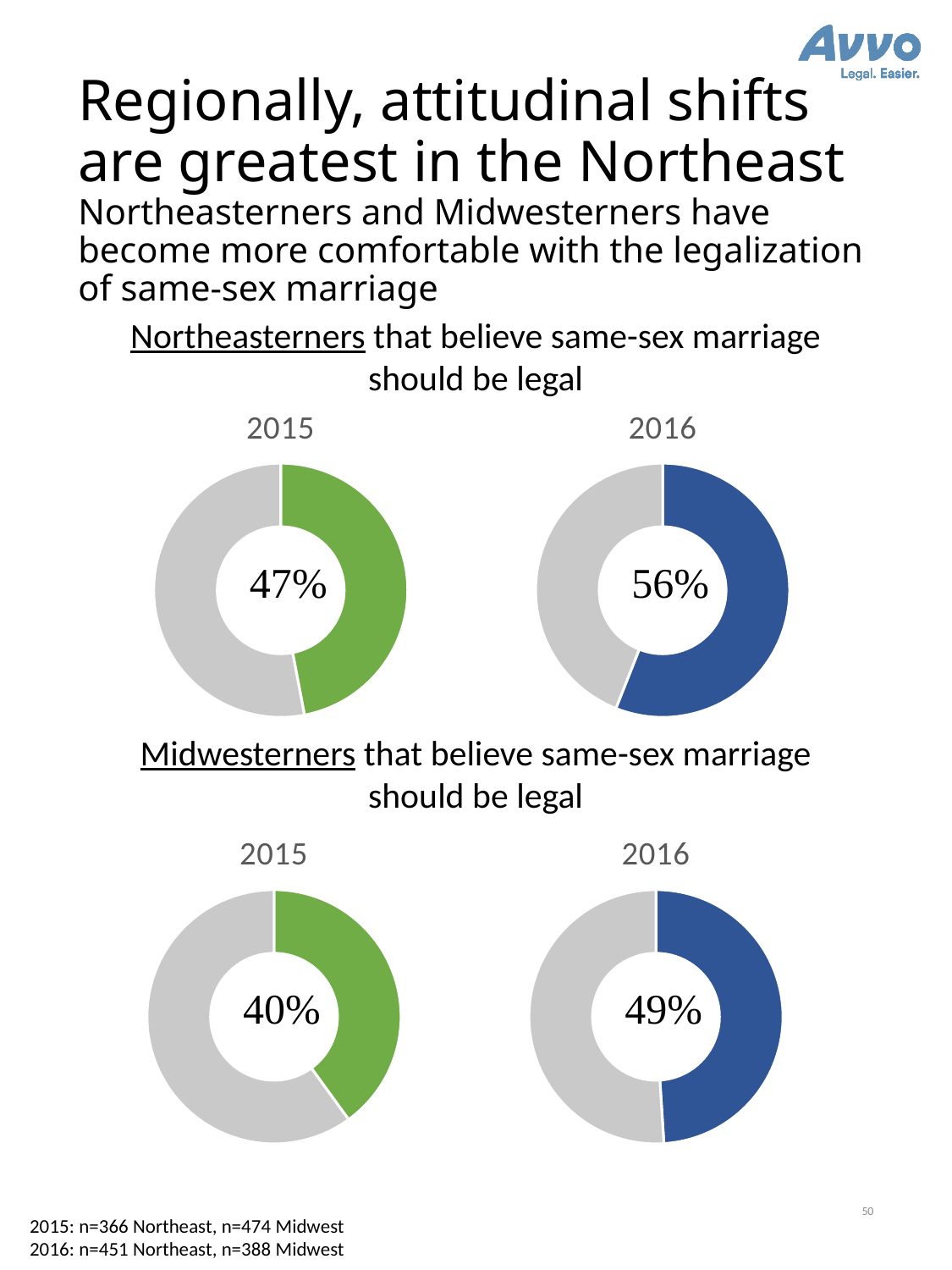
How many donut charts are shown on the slide? 4 Across all four donut charts on the slide, which chart shows the highest percentage? Northeasterners 2016 In the Northeasterners 2015 donut chart, what percentage believe same-sex marriage should be legal? 47% For the Northeasterners charts, by how many percentage points did the share believing same-sex marriage should be legal change from 2015 to 2016? 9 percentage points Across all four donut charts on the slide, which chart shows the lowest percentage? Midwesterners 2015 What kind of chart is used to show the percentages on this slide? donut chart In the Midwesterners 2016 donut chart, what percentage believe same-sex marriage should be legal? 49% Comparing the 2016 charts, which group has the larger share believing same-sex marriage should be legal, Northeasterners or Midwesterners? Northeasterners For the Northeasterners charts, did the share believing same-sex marriage should be legal rise or fall from 2015 to 2016? rise In the Midwesterners 2015 donut chart, what percentage believe same-sex marriage should be legal? 40% For the Midwesterners charts, by how many percentage points did the share believing same-sex marriage should be legal change from 2015 to 2016? 9 percentage points In the Northeasterners 2016 donut chart, what percentage believe same-sex marriage should be legal? 56%